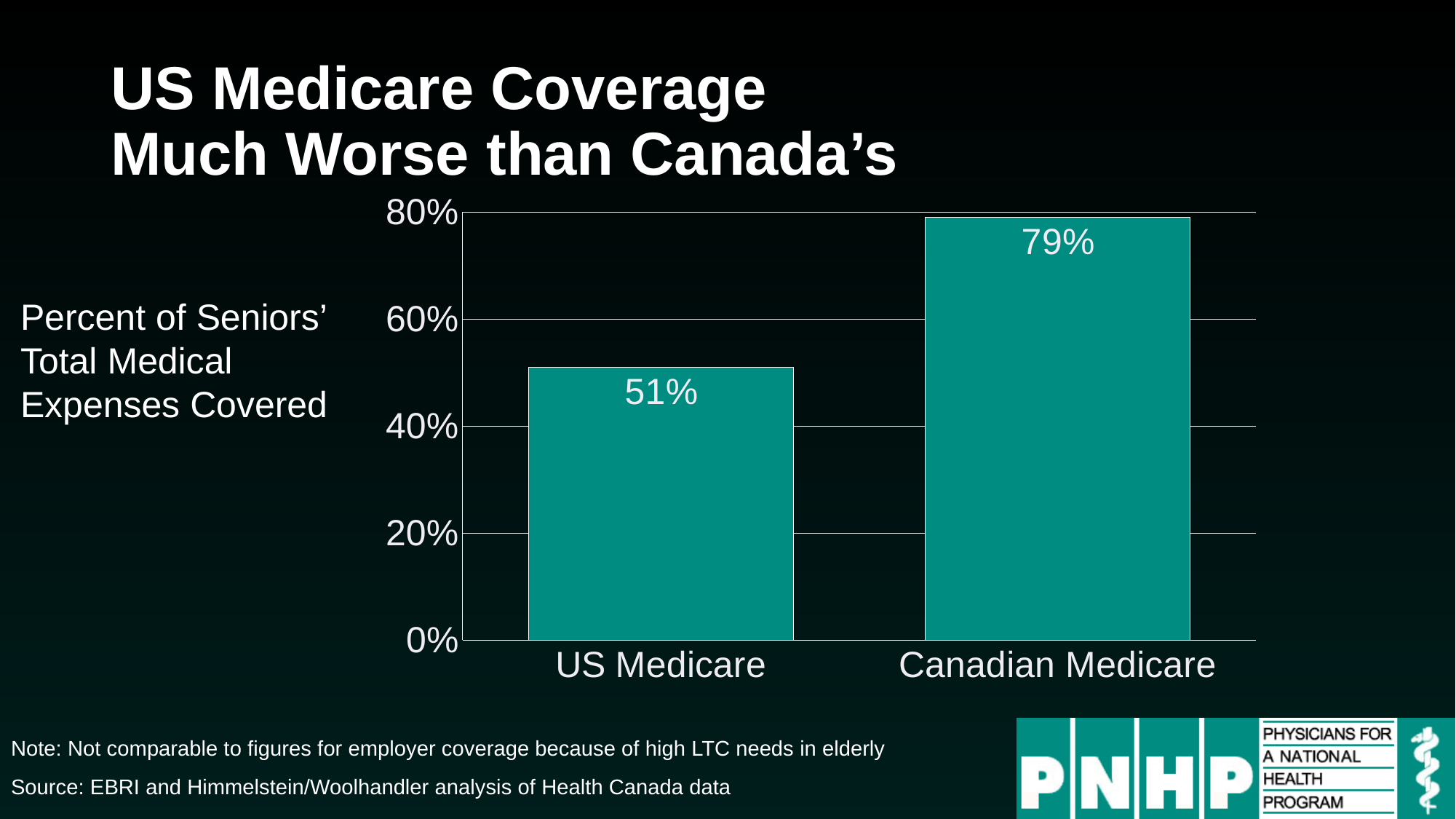
How many categories are shown on the chart? 2 What is the highest value shown on the vertical axis? 80% What kind of chart is shown on the slide? Bar chart Is the value for US Medicare greater or less than 60%? less What does the chart measure, according to the label to the left of it? Percent of Seniors' Total Medical Expenses Covered What is the difference in percentage points between Canadian Medicare and US Medicare coverage? 28 Which category has the lowest value on the chart? US Medicare Which category has the higher value, US Medicare or Canadian Medicare? Canadian Medicare What percent of seniors' total medical expenses is covered by US Medicare? 51% Is the value for Canadian Medicare greater or less than 60%? greater What percent of seniors' total medical expenses is covered by Canadian Medicare? 79%